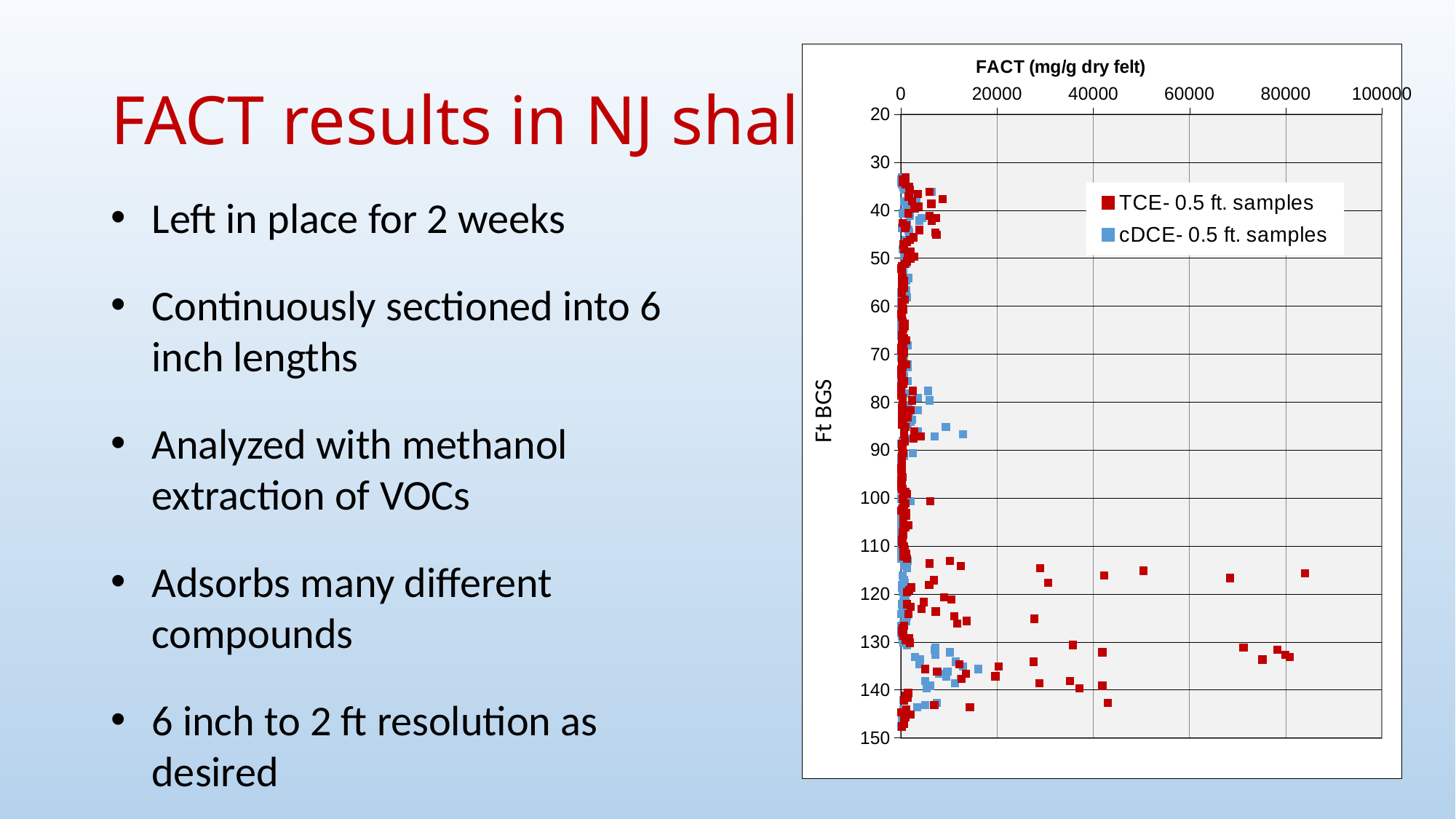
Is the highest cDCE value plotted on the chart greater or less than 20000? less What are the two series named in the chart legend? TCE- 0.5 ft. samples and cDCE- 0.5 ft. samples What kind of chart is shown on the slide? scatter chart Is the highest TCE value plotted on the chart greater or less than 80000? greater What is the title of the chart's x axis? FACT (mg/g dry felt) Which series reaches the highest FACT values on the chart, TCE or cDCE? TCE- 0.5 ft. samples Are the TCE values at depths between 50 and 100 Ft BGS greater or less than 20000? less Which series is plotted in red on the chart? TCE- 0.5 ft. samples How many series does the chart legend list? 2